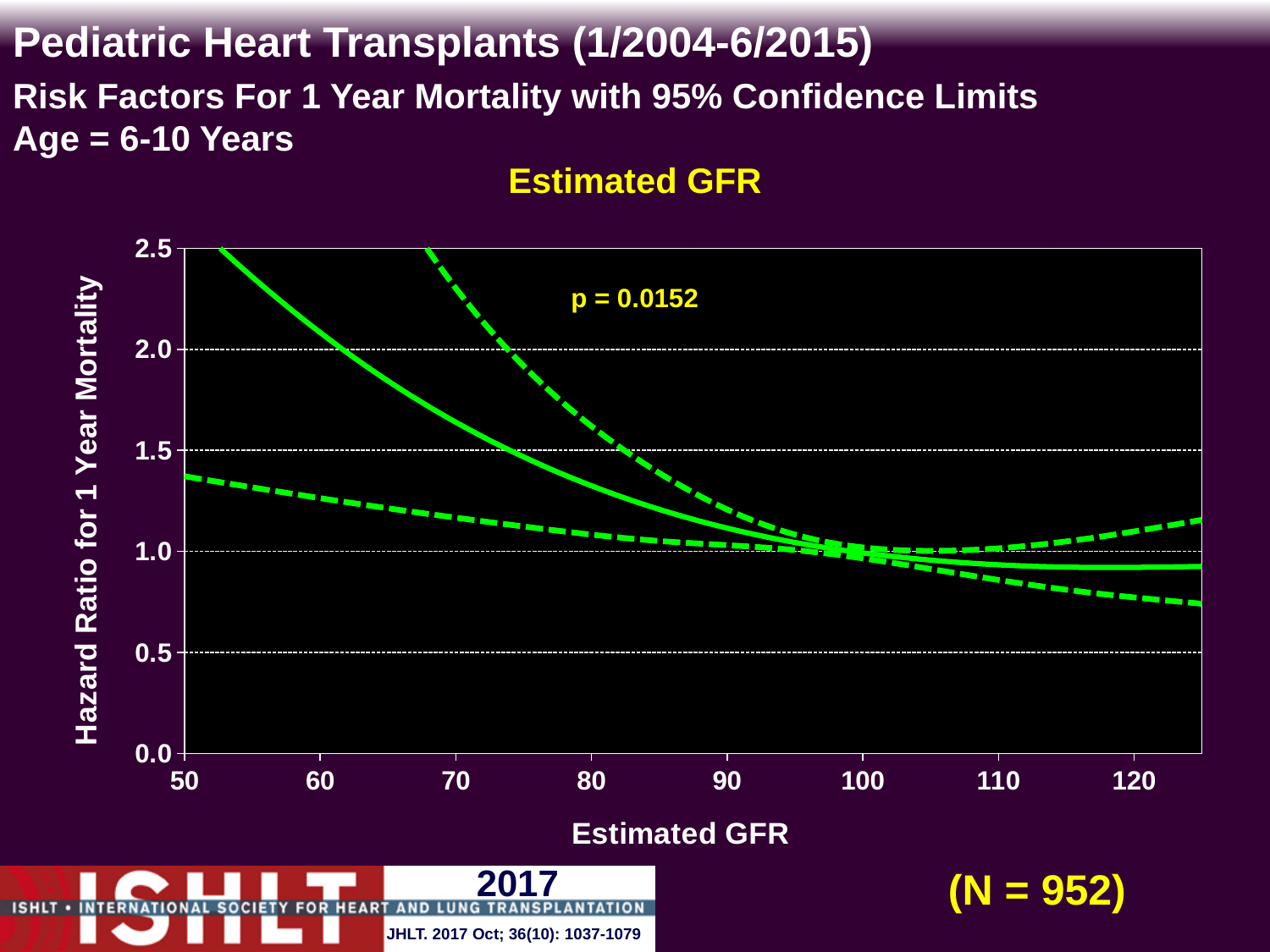
How many lines are plotted on the chart? 3 What sample size (N) is shown on the slide? N = 952 Is the lower confidence limit (lower dashed line) at an Estimated GFR of 50 greater or less than 1.5? less Does the solid hazard ratio line rise or fall as Estimated GFR increases from 50 to 100? falls Is the hazard ratio (solid line) at an Estimated GFR of 80 greater or less than 1.0? greater Is the lower confidence limit (lower dashed line) at an Estimated GFR of 120 greater or less than 1.0? less What kind of chart is shown on the slide? line chart What p-value is printed on the chart? p = 0.0152